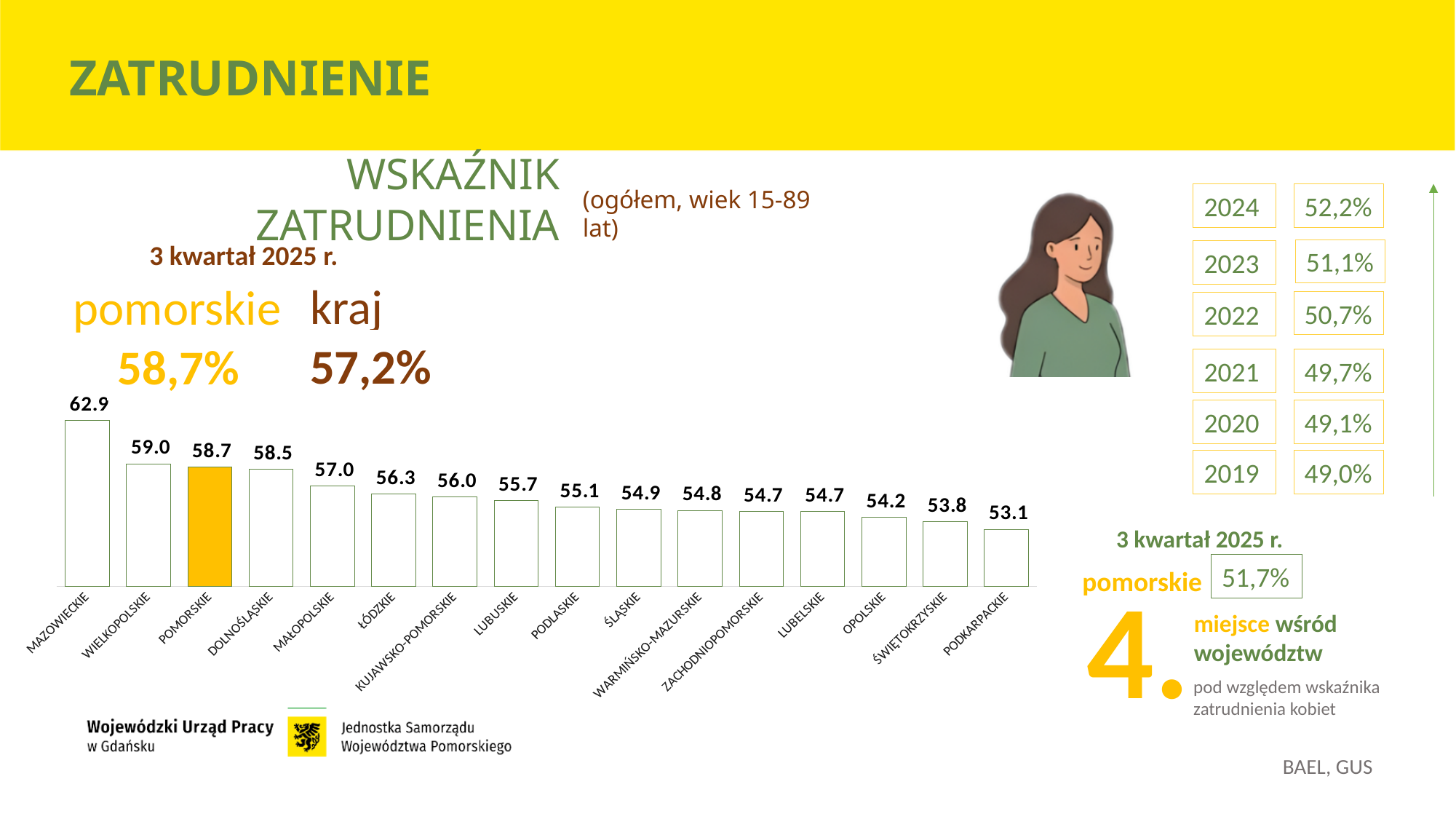
What is the value for PODKARPACKIE in the bar chart? 53.1 Which voivodeship has the highest value in the bar chart? MAZOWIECKIE What is the difference between the values for WIELKOPOLSKIE and POMORSKIE? 0.3 What is the difference between the values for MAZOWIECKIE and PODKARPACKIE? 9.8 Which has a larger value, MAŁOPOLSKIE or LUBUSKIE? MAŁOPOLSKIE What is the value for ŁÓDZKIE in the bar chart? 56.3 How many voivodeships are shown in the bar chart? 16 What is the value for MAZOWIECKIE in the bar chart? 62.9 Do the values rise or fall from left to right along the x axis? fall Which voivodeship has the lowest value in the bar chart? PODKARPACKIE What type of chart is shown on the slide? bar chart What is the value for POMORSKIE in the bar chart? 58.7